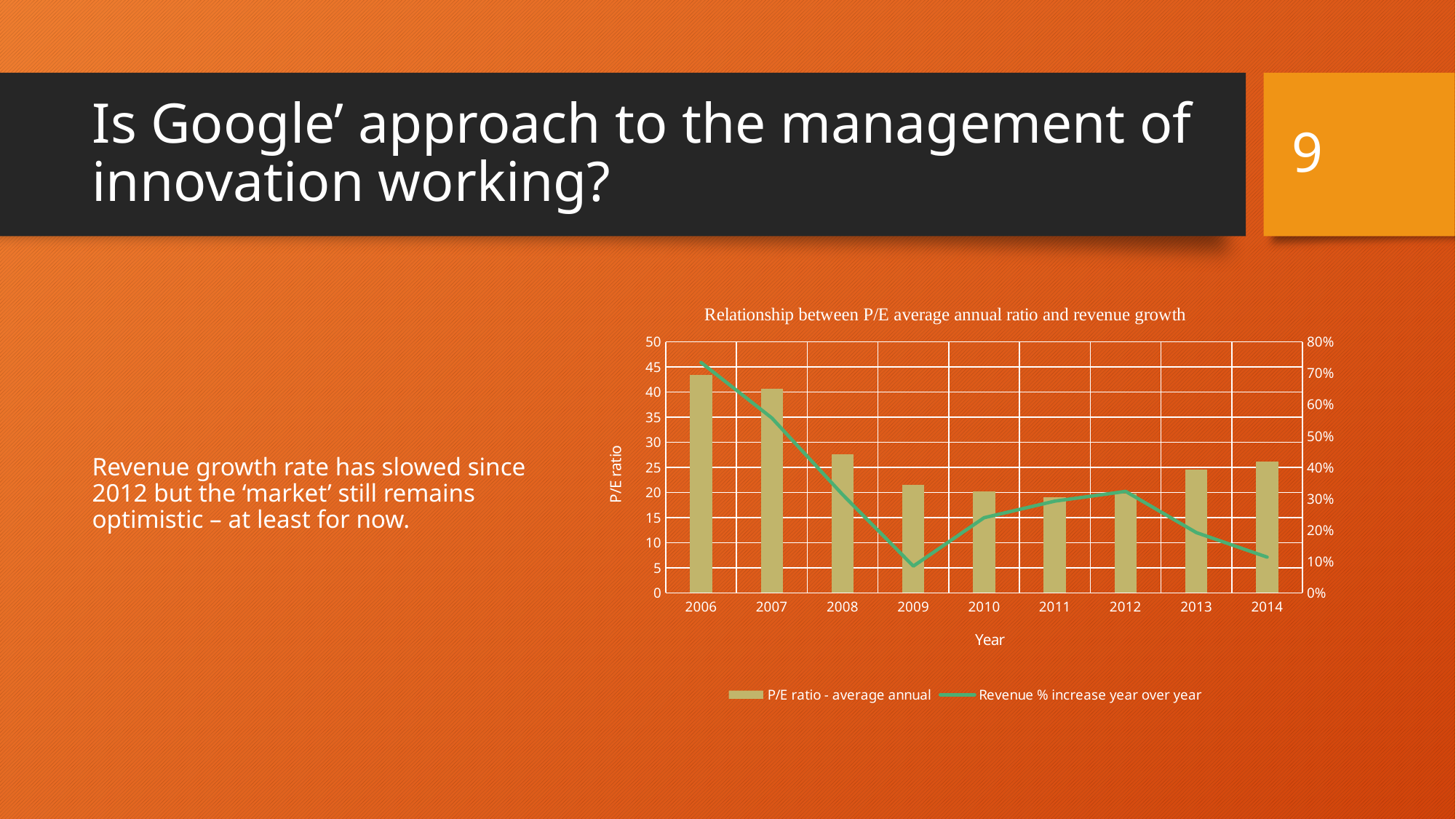
What is the title of the chart? Relationship between P/E average annual ratio and revenue growth In which year is the Revenue % increase year over year line at its lowest point? 2009 How many series does the chart's legend list? 2 Does the Revenue % increase year over year line rise or fall from 2006 to 2009? fall In which year is the Revenue % increase year over year line at its highest point? 2006 What kind of chart is shown on the slide? A combined bar and line chart Which year has the larger P/E ratio - average annual bar, 2006 or 2014? 2006 Is the Revenue % increase year over year for 2009 greater or less than 20%? less How many years are shown on the x axis of the chart? 9 Is the P/E ratio - average annual bar for 2010 greater or less than 25? less Which year has the highest P/E ratio - average annual bar? 2006 Is the P/E ratio - average annual bar for 2006 greater or less than 40? greater